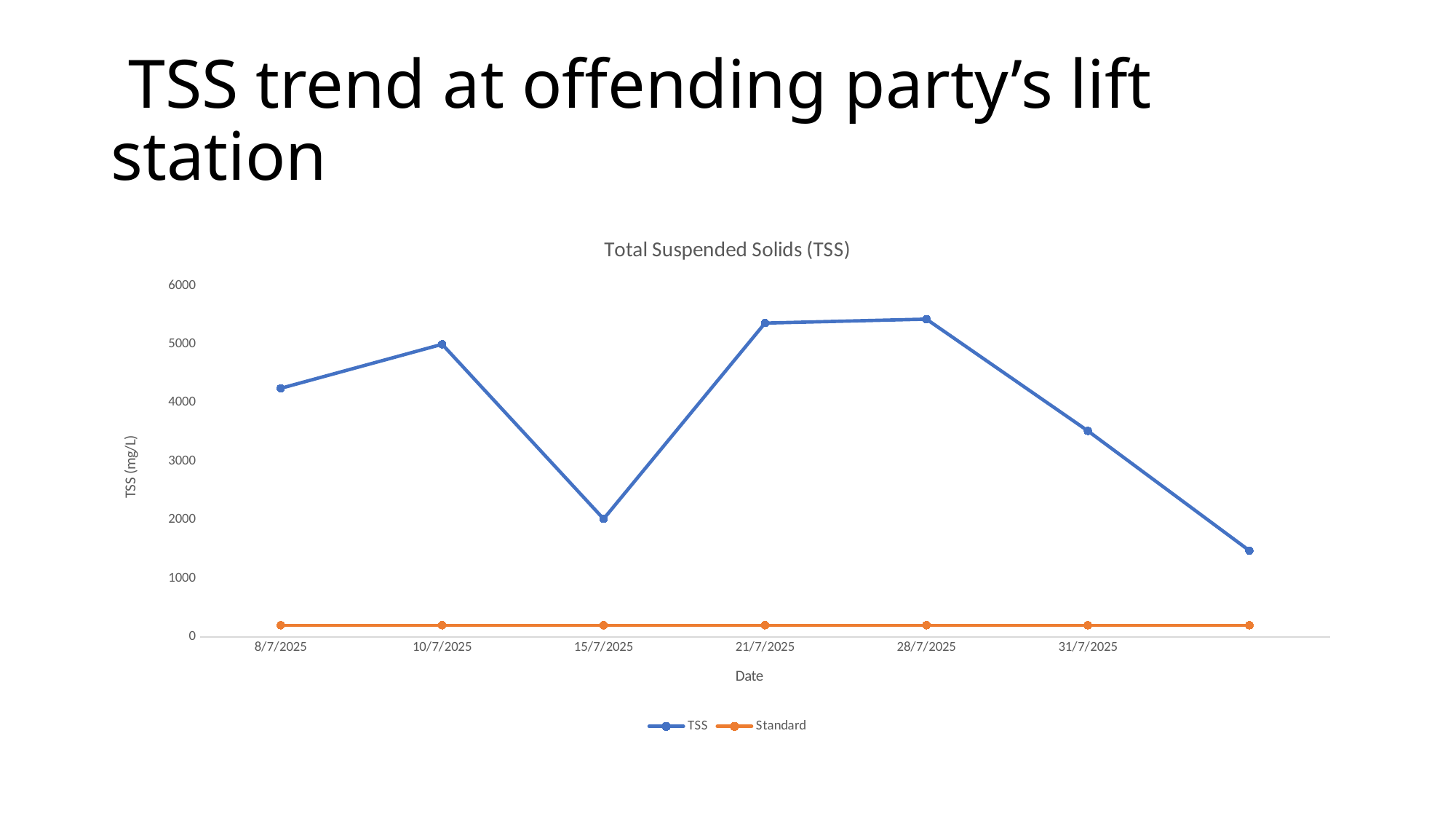
Which has the higher TSS value, 8/7/2025 or 10/7/2025? 10/7/2025 Is the TSS value for 21/7/2025 greater or less than 5000? greater Which has the higher TSS value, 15/7/2025 or 31/7/2025? 31/7/2025 Is the Standard value greater or less than 1000? less What are the two series named in the legend? TSS and Standard Is the TSS value for 8/7/2025 greater or less than 4000? greater What is the title of the chart? Total Suspended Solids (TSS) How many dates are labelled on the x axis? 6 Does the TSS line rise or fall from 28/7/2025 to 31/7/2025? fall How many series does the legend list? 2 What kind of chart is shown on the slide? line chart